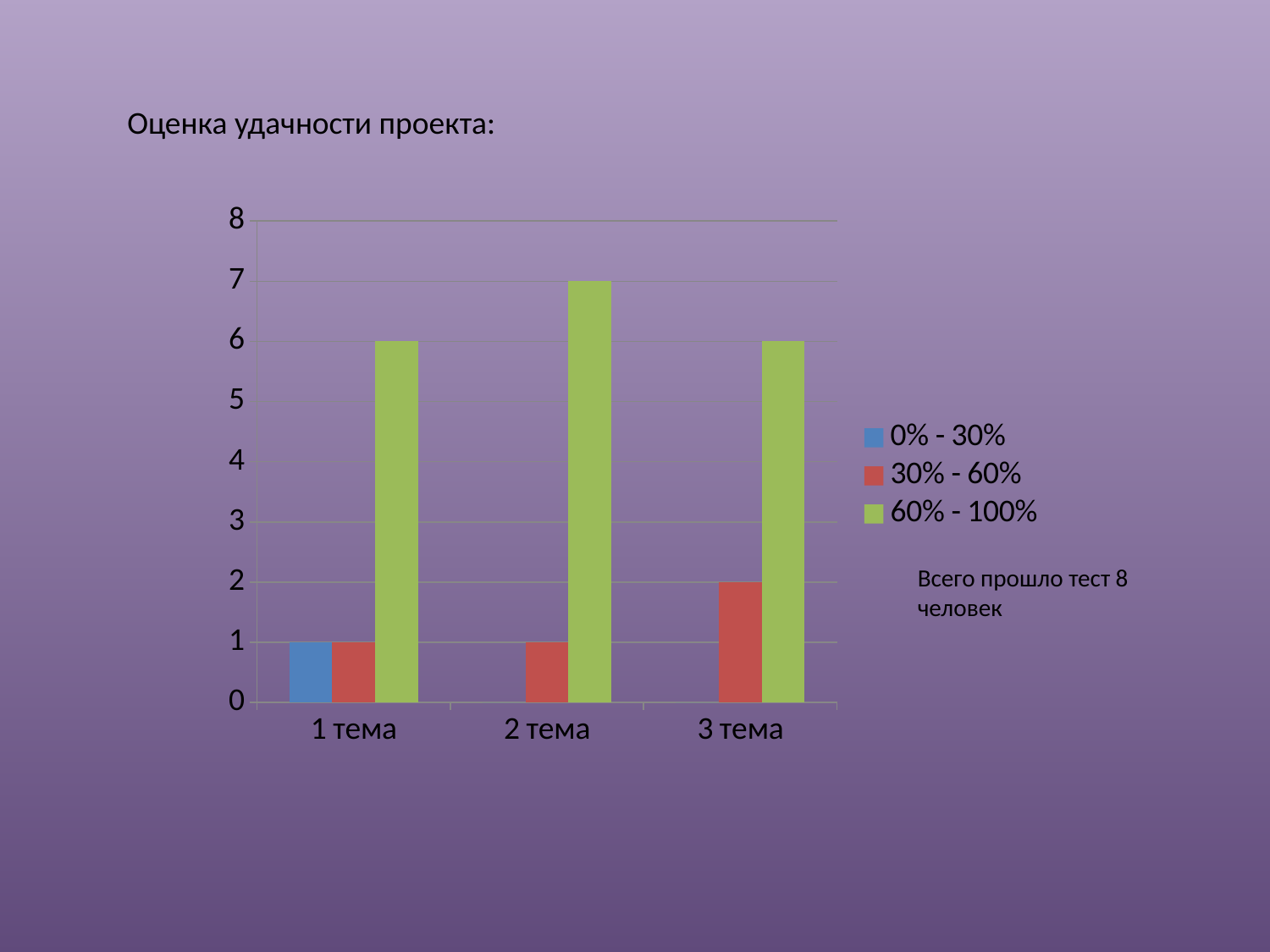
What is the value of the 60% - 100% series for 2 тема? 7 How many categories are shown on the x axis? 3 For which category is the 60% - 100% series highest? 2 тема What is the difference between the 60% - 100% values for 2 тема and 3 тема? 1 What is the title text above the chart? Оценка удачности проекта: Which is larger for 3 тема: the 30% - 60% series or the 60% - 100% series? 60% - 100% How many series does the legend list? 3 For which category is the 30% - 60% series highest? 3 тема What is the value of the 60% - 100% series for 1 тема? 6 What kind of chart is shown on the slide? bar chart What is the value of the 30% - 60% series for 3 тема? 2 What is the value of the 0% - 30% series for 1 тема? 1